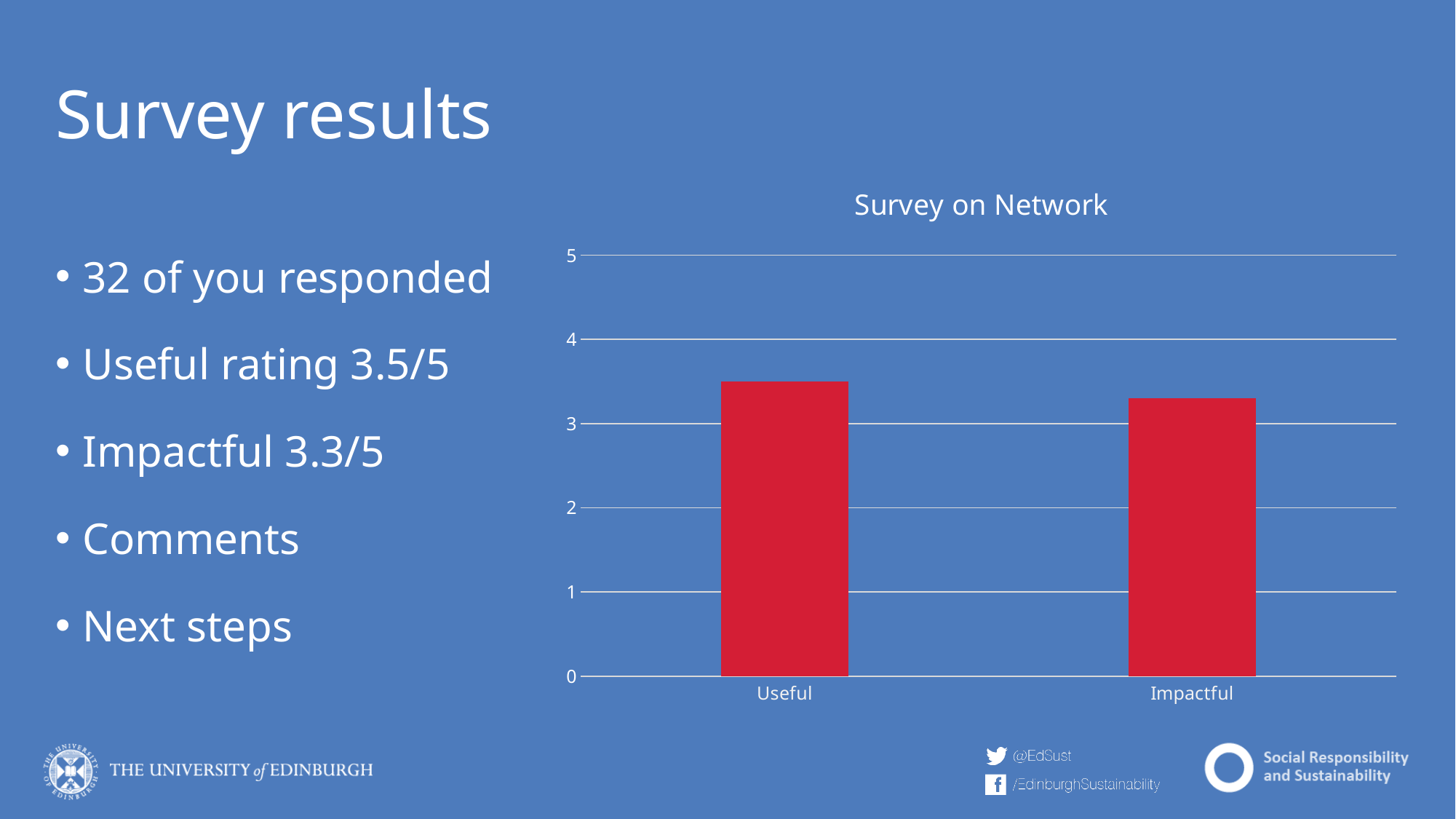
Is the value for Useful greater or less than 3? greater Is the value for Impactful greater or less than 3? greater What is the maximum value shown on the y axis of the chart? 5 What is the title of the chart? Survey on Network Is the value for Useful greater or less than 4? less What kind of chart is shown on the slide? bar chart Which category has the lowest bar in the chart? Impactful Which bar is taller, Useful or Impactful? Useful Do the bar values rise or fall from Useful to Impactful? fall How many categories are shown on the x axis of the chart? 2 Which category has the highest bar in the chart? Useful